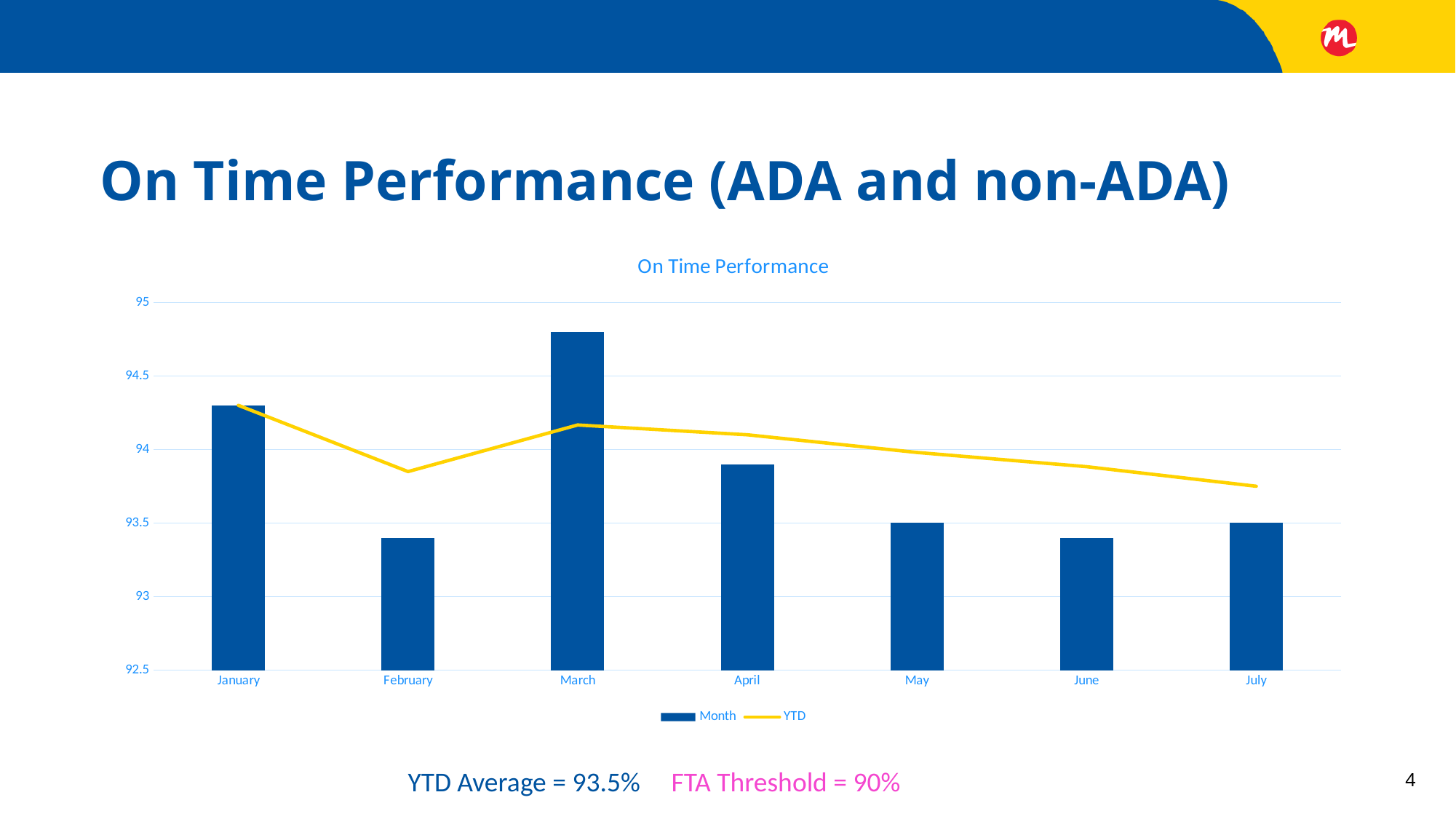
Does the YTD line rise or fall overall from January to July? fall Is the Month value for March greater or less than 94.5? greater Which has the larger Month value, January or April? January How many months are shown on the x axis? 7 What are the two series named in the legend? Month and YTD Which month has the highest Month bar? March Is the Month value for February greater or less than 93.5? less Is the Month value for January greater or less than 94? greater What is the title of the chart? On Time Performance What kind of chart is shown? Bar chart with a line series How many series does the legend list? 2